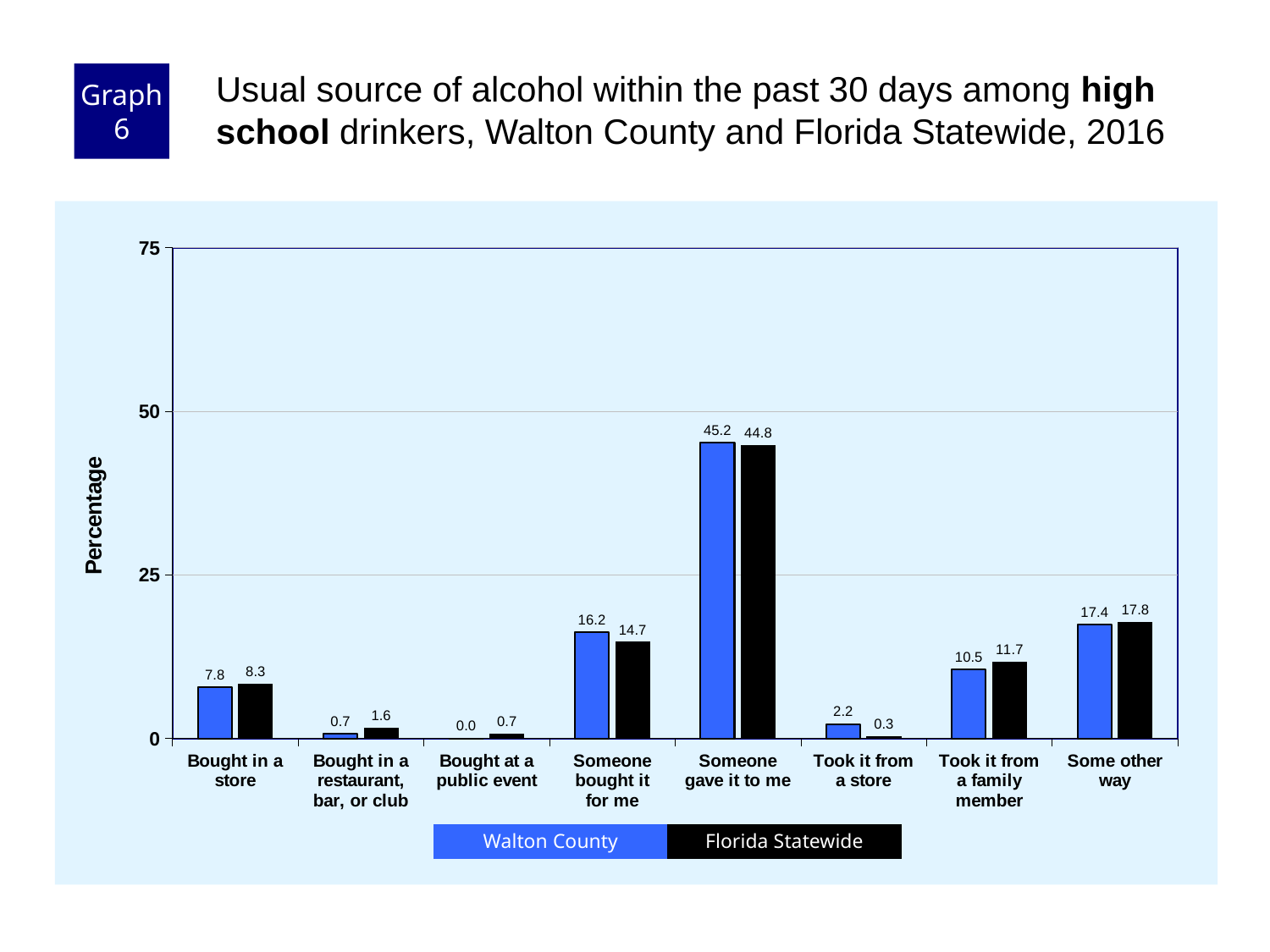
Which category has the lowest Walton County value? Bought at a public event Is the Walton County value for "Some other way" greater or less than 25? less For "Took it from a store", which is larger: Walton County or Florida Statewide? Walton County What kind of chart is shown on the slide? Bar chart What colour represents Florida Statewide in the chart? Black What is the Florida Statewide value for "Took it from a family member"? 11.7 Which category has the highest Florida Statewide value? Someone gave it to me How many series does the legend list? 2 What is the Walton County value for "Someone gave it to me"? 45.2 What is the Walton County value for "Bought at a public event"? 0.0 How many source categories are shown on the x axis? 8 What is the difference between the Walton County and Florida Statewide values for "Someone bought it for me"? 1.5